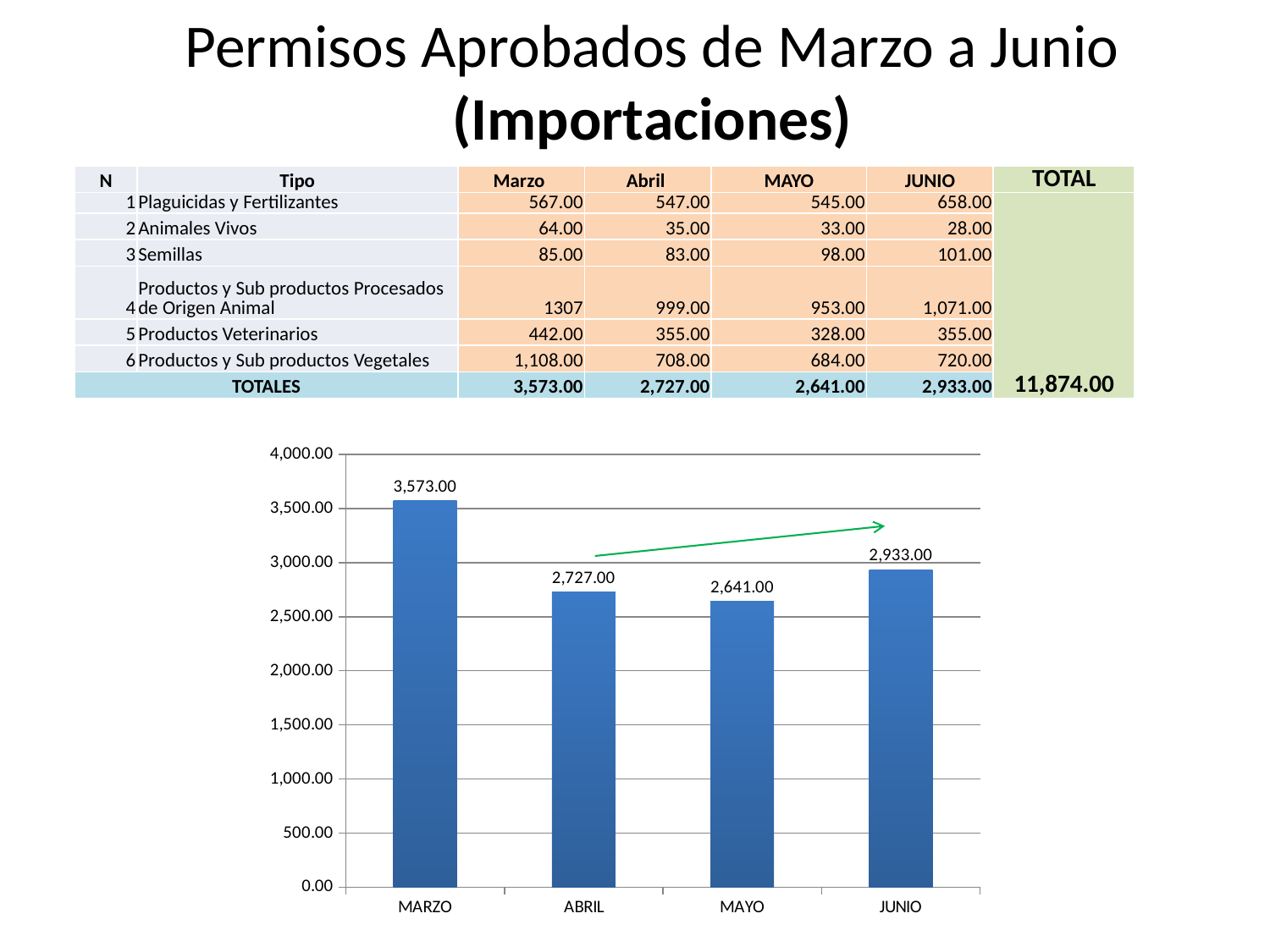
Is the value for ABRIL in the bar chart greater or less than 3,000.00? less What is the value for MARZO in the bar chart? 3,573.00 What kind of chart is shown on the slide? bar chart Which month has the highest bar in the chart? MARZO What is the value for MAYO in the bar chart? 2,641.00 Does the value rise or fall from MARZO to ABRIL in the bar chart? fall What is the difference between the MARZO and ABRIL values in the bar chart? 846.00 What is the difference between the JUNIO and MAYO values in the bar chart? 292.00 Which is larger in the bar chart, the value for ABRIL or the value for JUNIO? JUNIO How many bars are shown in the chart? 4 What is the value for JUNIO in the bar chart? 2,933.00 Which month has the lowest bar in the chart? MAYO